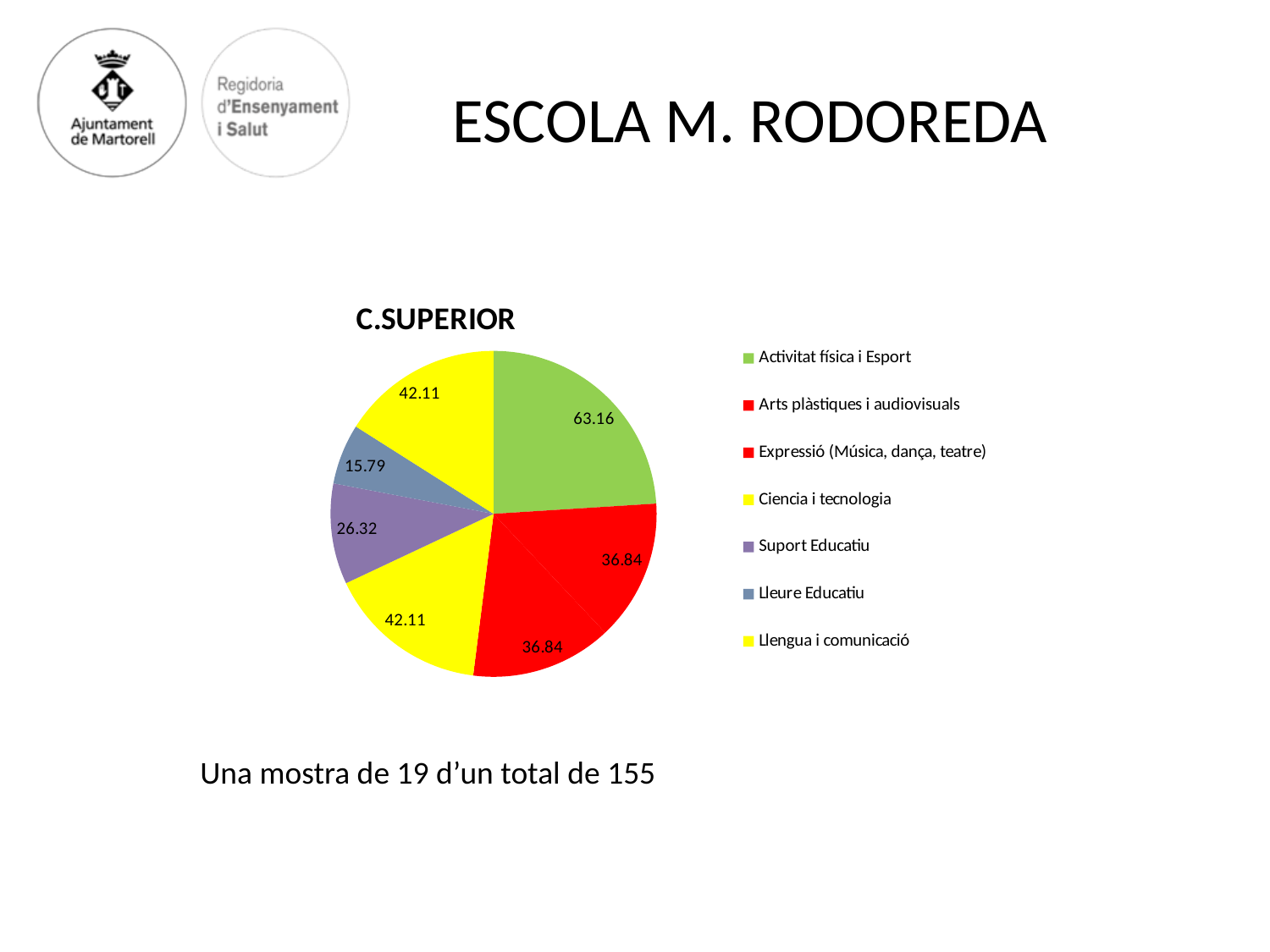
How many categories does the legend of the pie chart list? 7 What kind of chart is shown on the slide? pie chart What is the value shown for Suport Educatiu? 26.32 Which category has the largest slice of the pie? Activitat física i Esport What is the value shown for Lleure Educatiu? 15.79 What is the value shown for Ciencia i tecnologia? 42.11 What is the value shown for Arts plàstiques i audiovisuals? 36.84 What is the value shown for Activitat física i Esport? 63.16 Which is larger, the value for Suport Educatiu or the value for Llengua i comunicació? Llengua i comunicació Which category has the smallest slice of the pie? Lleure Educatiu What is the title of the chart? C.SUPERIOR What is the difference between the values for Activitat física i Esport and Lleure Educatiu? 47.37